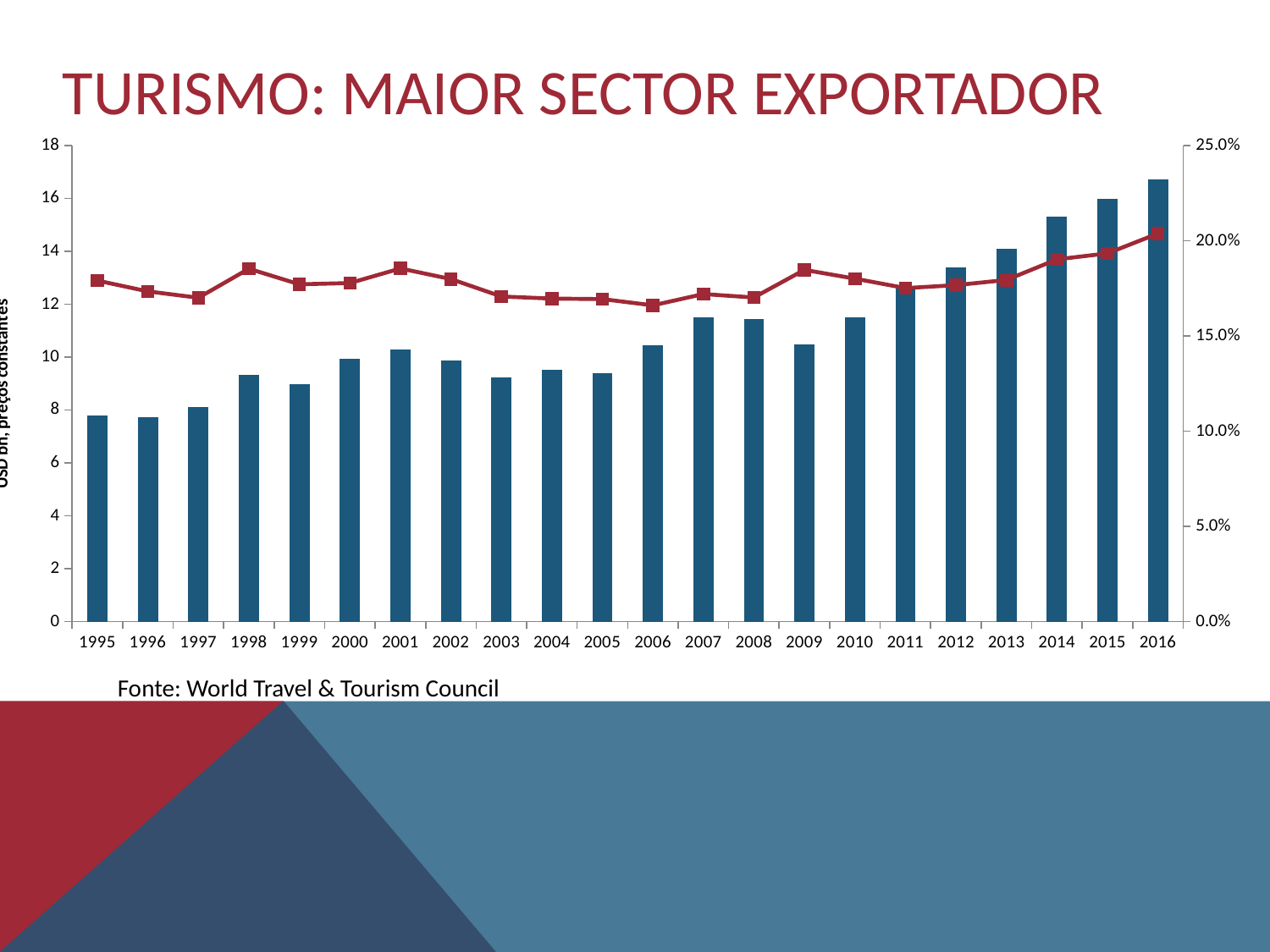
Is the line value for 2006 on the right axis greater or less than 15.0%? greater Which bar is taller, 2001 or 2003? 2001 What source is cited below the chart? World Travel & Tourism Council Which year has the highest point on the line series? 2016 How many years are shown along the x axis of the chart? 22 Is the line value for 2016 on the right axis greater or less than 20.0%? greater Is the bar value for 1995 greater or less than 8? less Do the bar values generally rise or fall from 1995 to 2016? rise What kind of chart is shown on the slide? A combined bar and line chart Which year has the tallest bar in the chart? 2016